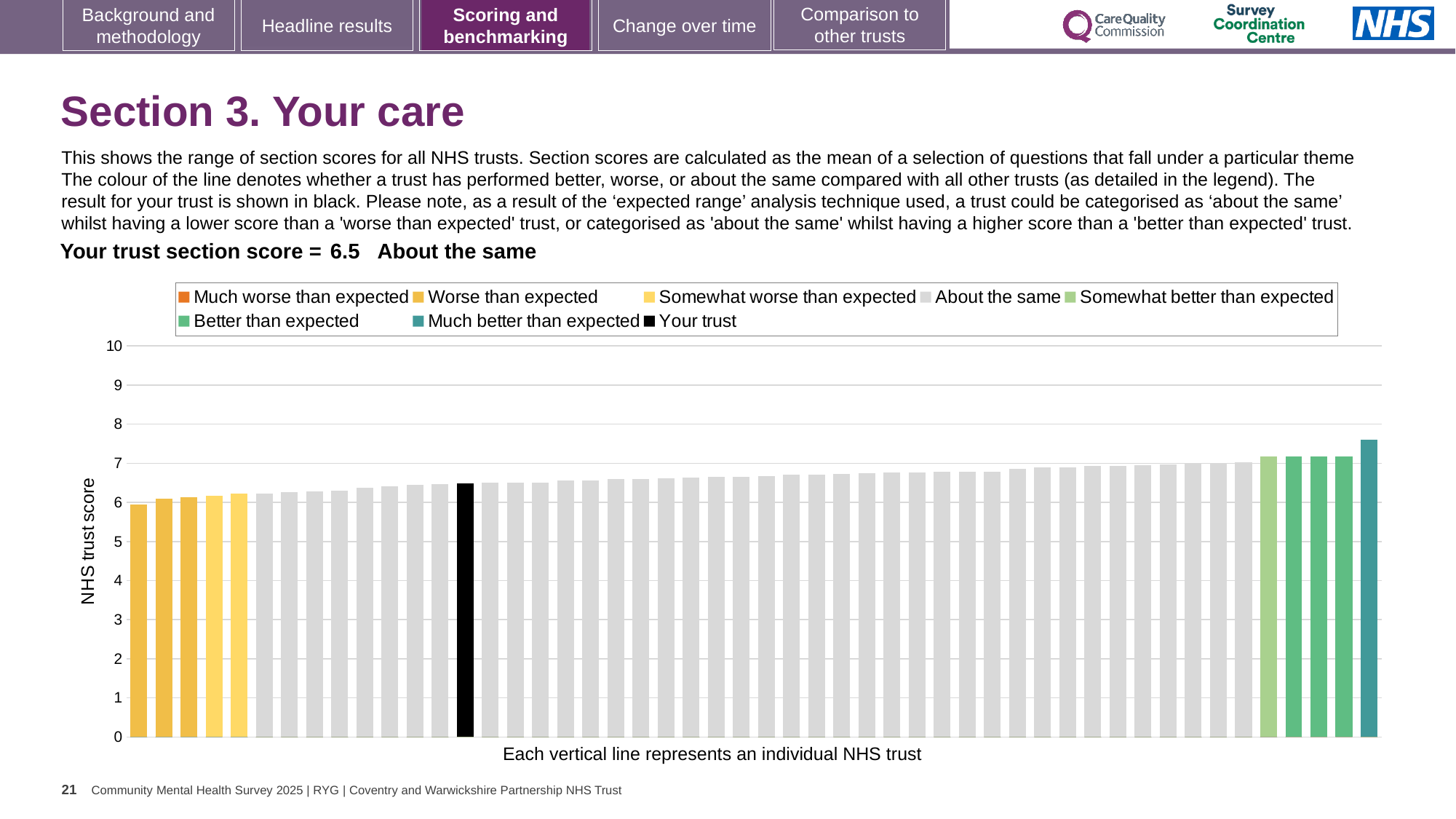
How many entries does the chart legend list? 8 Which legend category does the tallest bar belong to? Much better than expected Is the tallest bar in the chart greater or less than 7? greater Is your trust's bar higher or lower than the tallest bar in the chart? lower What kind of chart is shown on the slide? bar chart Is the shortest bar in the chart greater or less than 5? greater What is the section score for your trust shown on the slide? 6.5 What is the label on the vertical axis of the chart? NHS trust score Is the value for your trust greater or less than 5? greater Which category is your trust placed in for this section score? About the same Do the bar values rise or fall from left to right along the x axis? rise